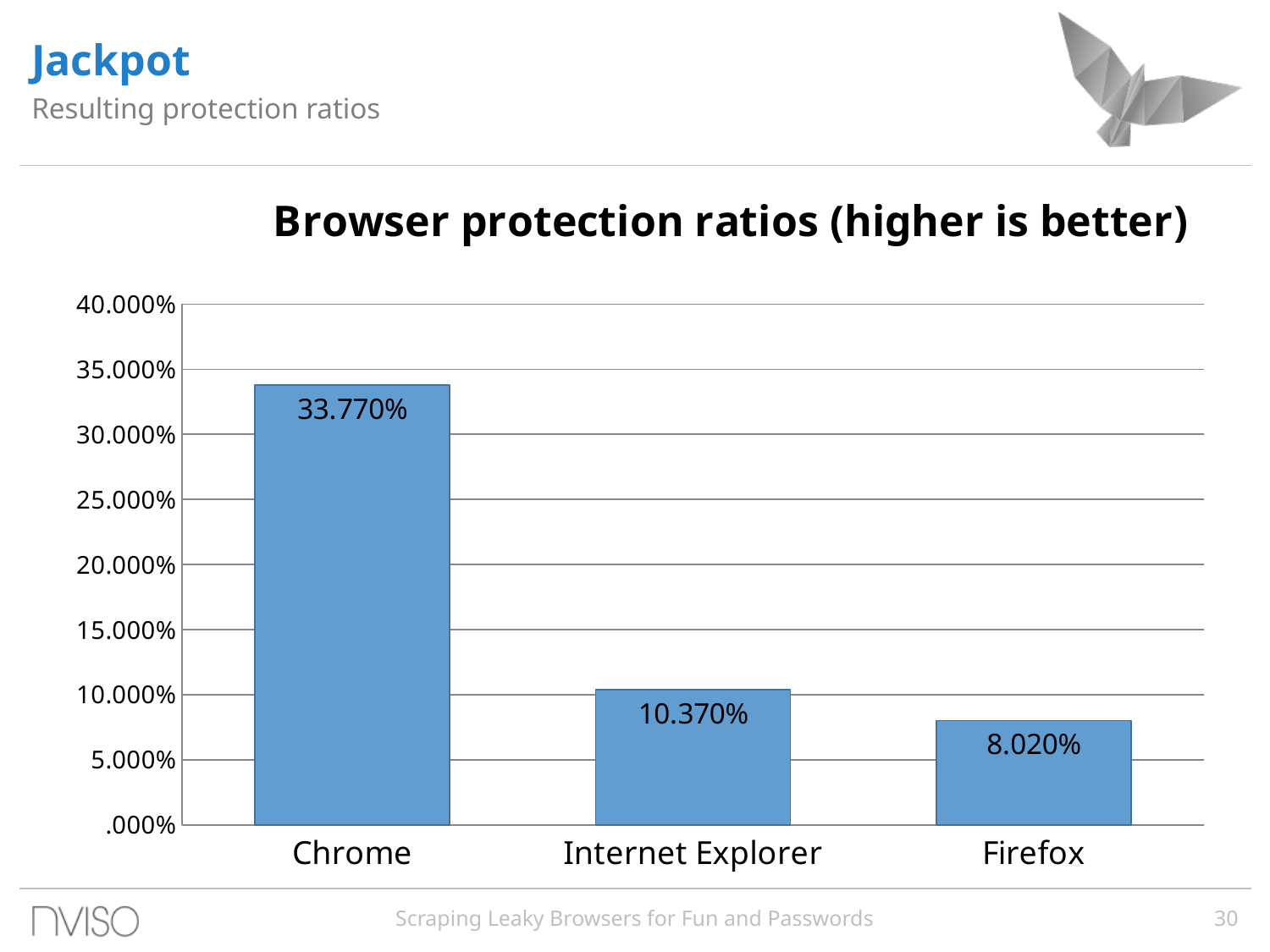
Is the value for Chrome greater or less than 30.000%? greater Which browser has the highest protection ratio? Chrome Which has a higher protection ratio, Internet Explorer or Firefox? Internet Explorer What is the title of the chart? Browser protection ratios (higher is better) Which browser has the lowest protection ratio? Firefox What is the difference between the protection ratios of Internet Explorer and Firefox? 2.350% What is the protection ratio for Internet Explorer? 10.370% What kind of chart is shown on the slide? Bar chart How many browsers are shown in the chart? 3 What is the protection ratio for Firefox? 8.020% What is the difference between the protection ratios of Chrome and Internet Explorer? 23.400% What is the protection ratio for Chrome? 33.770%